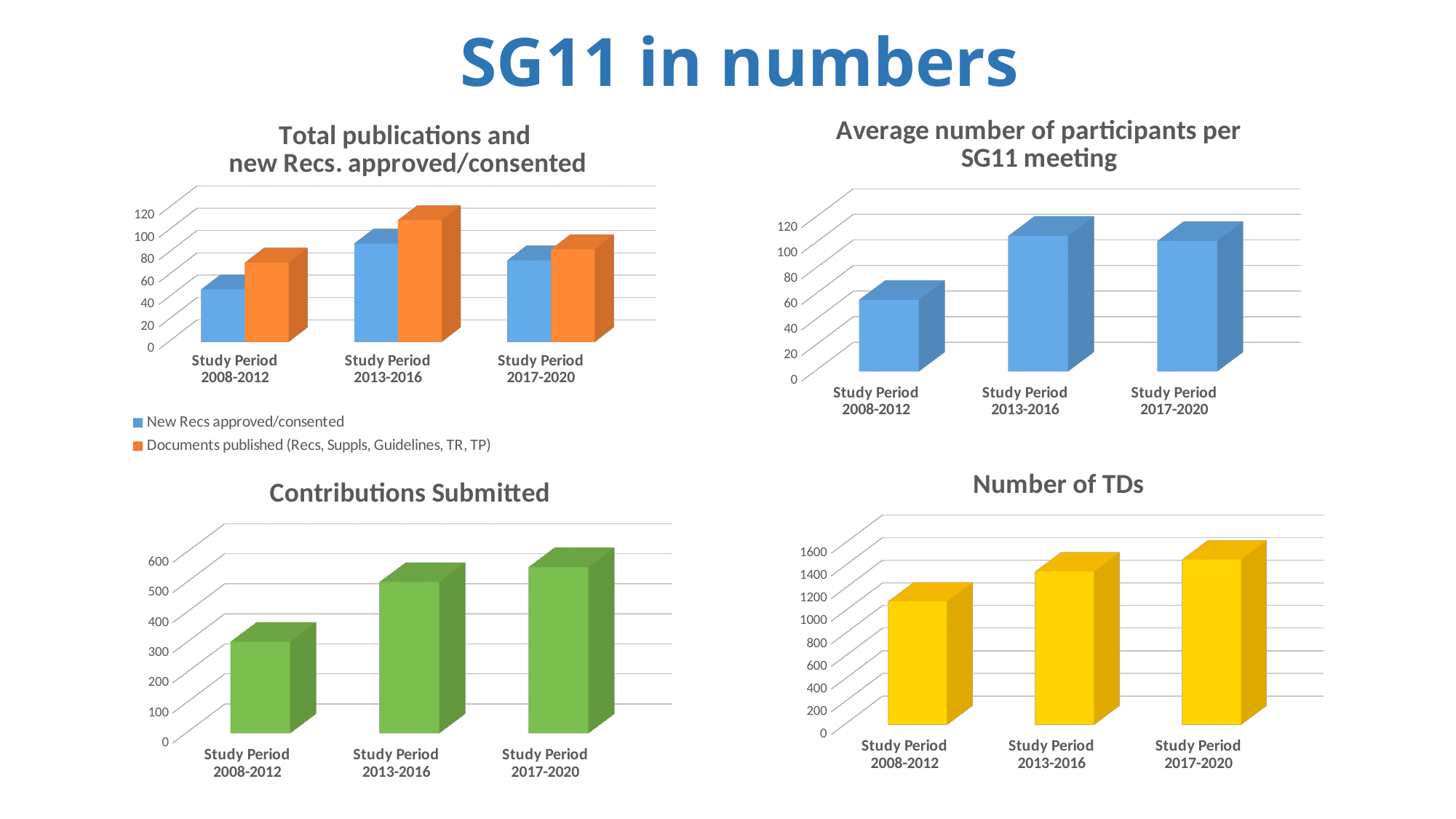
In the "Average number of participants per SG11 meeting" chart, is the value for Study Period 2008-2012 greater or less than 80? less In the "Number of TDs" chart, is the value for Study Period 2008-2012 greater or less than 1000? greater In the "Average number of participants per SG11 meeting" chart, which study period has the lowest value? Study Period 2008-2012 In the "Number of TDs" chart, do the values rise or fall from Study Period 2008-2012 to Study Period 2017-2020? rise How many study periods are shown on the "Number of TDs" chart? 3 In the "Total publications and new Recs. approved/consented" chart, which is larger for Study Period 2013-2016: New Recs approved/consented or Documents published? Documents published What kind of chart is the "Contributions Submitted" chart? bar chart How many series does the legend of the "Total publications and new Recs. approved/consented" chart list? 2 In the "Total publications and new Recs. approved/consented" chart, which colour represents Documents published (Recs, Suppls, Guidelines, TR, TP)? orange In the "Contributions Submitted" chart, is the value for Study Period 2008-2012 greater or less than 400? less In the "Contributions Submitted" chart, which study period has the lowest value? Study Period 2008-2012 In the "Contributions Submitted" chart, which study period has the highest value? Study Period 2017-2020